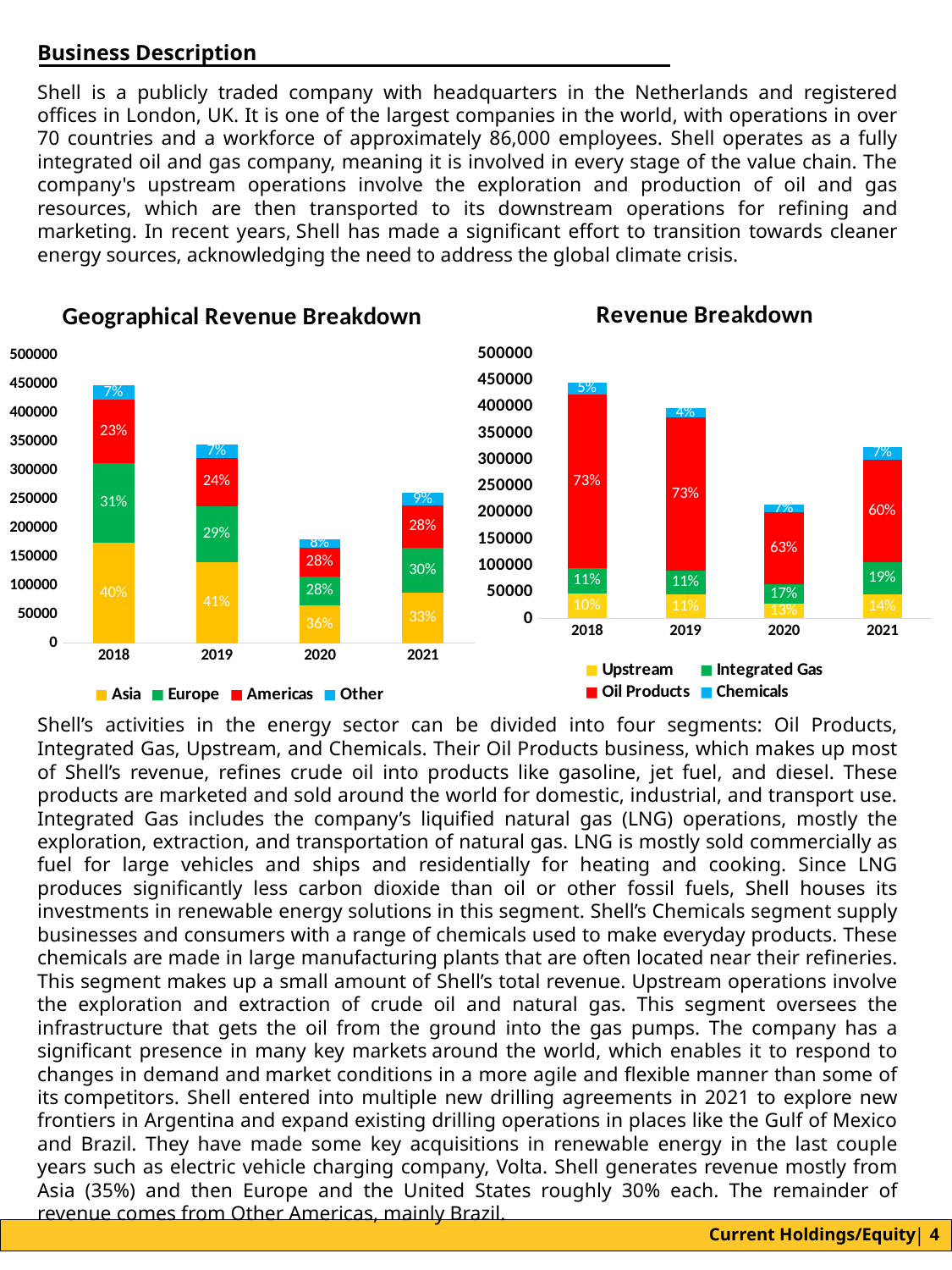
In the Geographical Revenue Breakdown chart, what is the difference between the Asia percentage in 2019 and the Asia percentage in 2021? 8% In the Revenue Breakdown chart, which is larger in 2020: the Upstream percentage or the Integrated Gas percentage? Integrated Gas In the Geographical Revenue Breakdown chart, which year has the lowest total bar? 2020 In the Geographical Revenue Breakdown chart, is the total bar for 2020 greater or less than 200000? less In the Revenue Breakdown chart, is the total bar for 2021 greater or less than 300000? greater In the Revenue Breakdown chart, what percentage label is shown for Oil Products in 2020? 63% What type of chart is the Geographical Revenue Breakdown chart? Stacked bar chart In the Revenue Breakdown chart, which year has the highest total bar? 2018 How many series does the legend of the Revenue Breakdown chart list? 4 In the Geographical Revenue Breakdown chart, what percentage label is shown for Americas in 2021? 28% In the Revenue Breakdown chart, what percentage label is shown for Integrated Gas in 2021? 19% In the Geographical Revenue Breakdown chart, what percentage label is shown for Asia in 2018? 40%